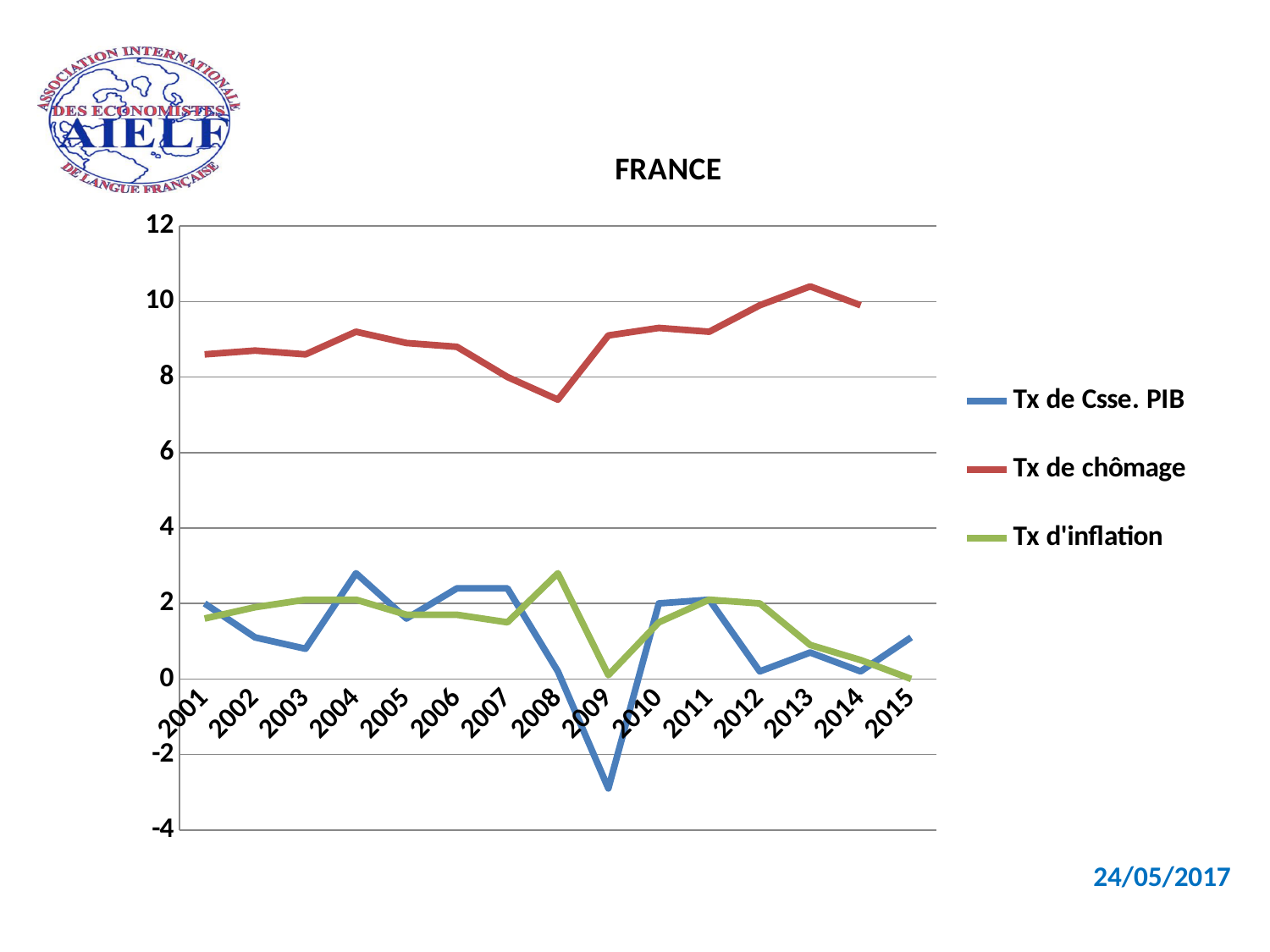
In 2008, which is larger: Tx d'inflation or Tx de Csse. PIB? Tx d'inflation Is the value of Tx de chômage in 2013 greater or less than 10? greater In which year does Tx de Csse. PIB reach its lowest value? 2009 In which year does Tx de chômage reach its highest value? 2013 Does Tx de chômage rise or fall between 2009 and 2013? rise Is the value of Tx de Csse. PIB in 2009 greater or less than -2? less How many years are shown along the x axis? 15 Is the value of Tx de chômage in 2008 greater or less than 8? less What kind of chart is shown on the slide? line chart How many series does the legend list? 3 Which colour is used for the Tx de chômage series? red What is the title of the chart? FRANCE